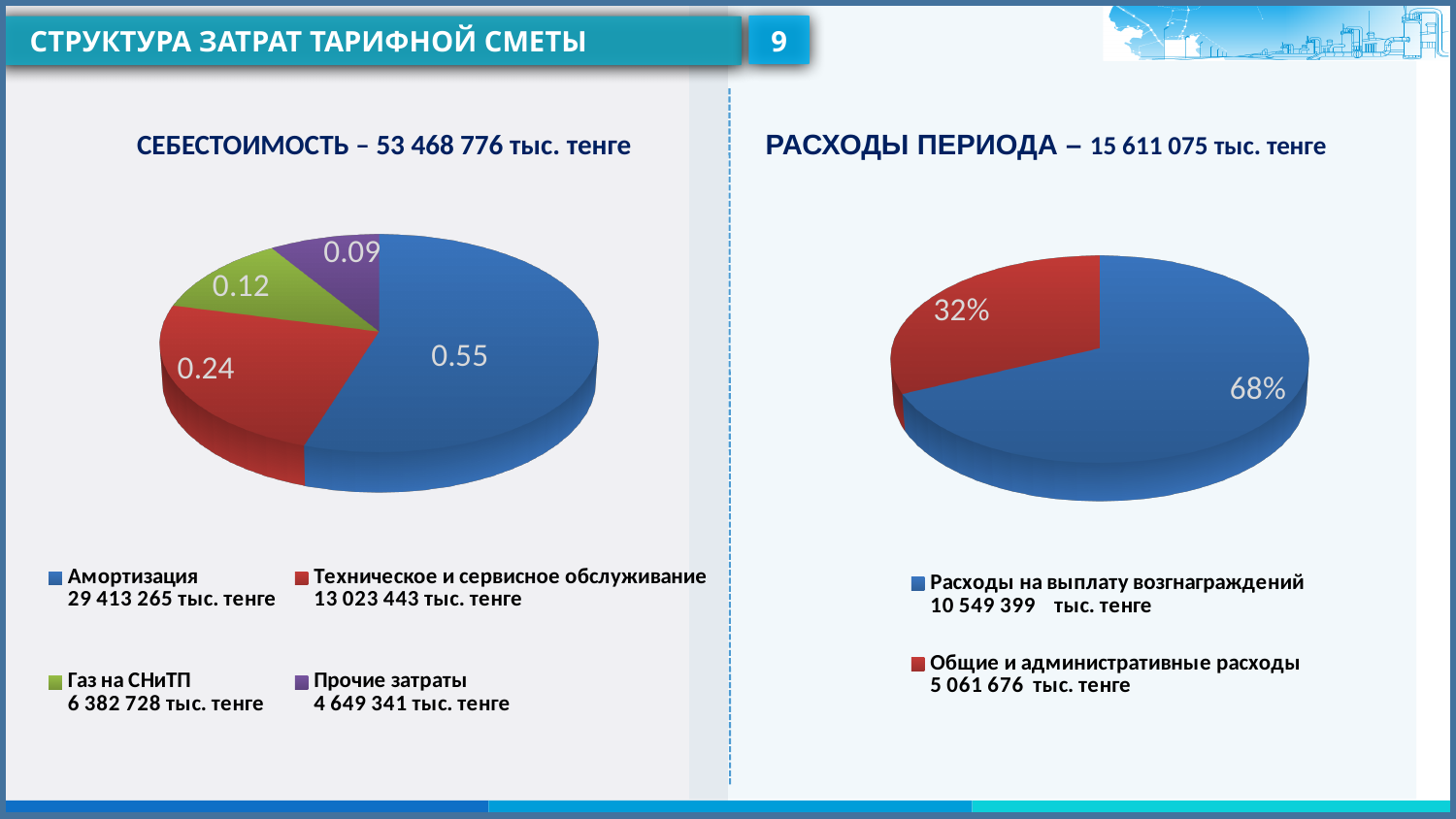
In the right pie chart (РАСХОДЫ ПЕРИОДА), what colour is the slice for Общие и административные расходы? Red In the right pie chart (РАСХОДЫ ПЕРИОДА), which is larger: Расходы на выплату вознаграждений or Общие и административные расходы? Расходы на выплату вознаграждений In the left pie chart (СЕБЕСТОИМОСТЬ), how many slices does the pie have? 4 In the left pie chart (СЕБЕСТОИМОСТЬ), what share is shown for Амортизация? 0.55 In the left pie chart (СЕБЕСТОИМОСТЬ), what share is shown for Газ на СНиТП? 0.12 What kind of chart is shown on the left side of the slide under "СЕБЕСТОИМОСТЬ"? Pie chart In the left pie chart (СЕБЕСТОИМОСТЬ), what is the difference between the shares for Амортизация and Техническое и сервисное обслуживание? 0.31 In the left pie chart (СЕБЕСТОИМОСТЬ), what share is shown for Техническое и сервисное обслуживание? 0.24 In the right pie chart (РАСХОДЫ ПЕРИОДА), what percentage is shown for Расходы на выплату вознаграждений? 68% In the left pie chart (СЕБЕСТОИМОСТЬ), which category has the largest slice? Амортизация In the left pie chart (СЕБЕСТОИМОСТЬ), which category has the smallest slice? Прочие затраты In the right pie chart (РАСХОДЫ ПЕРИОДА), what percentage is shown for Общие и административные расходы? 32%